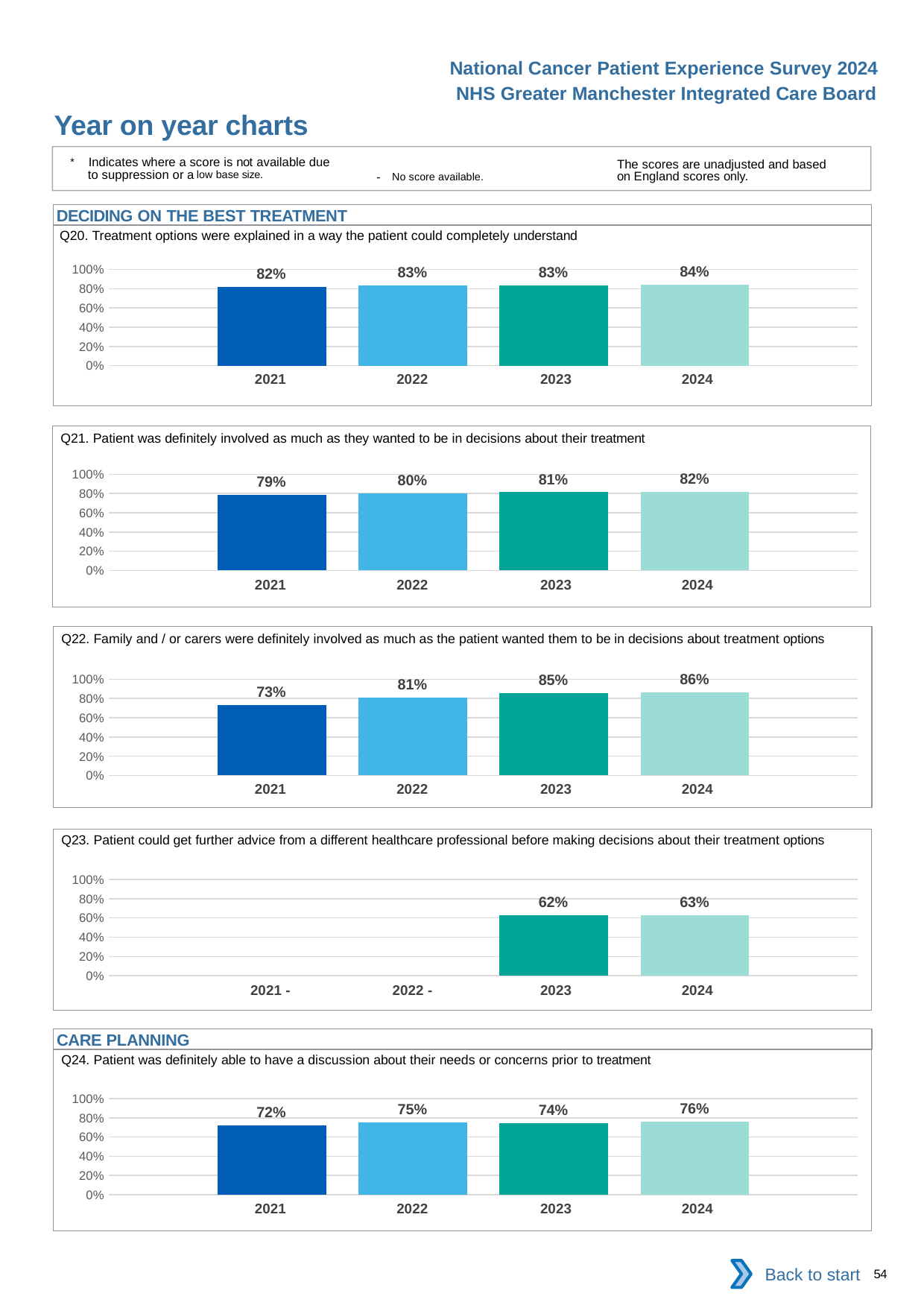
In the Q23 chart, what is the value for 2023? 62% What kind of chart is used for Q21? bar chart In the Q22 chart, which year has the lowest value? 2021 In the Q23 chart, how many years have a bar plotted? 2 In the Q24 chart, which is larger, the value for 2022 or the value for 2023? 2022 In the Q20 chart, is the value for 2021 greater or less than 80%? greater In the Q20 chart, what is the value for 2024? 84% In the Q22 chart, do the values rise or fall from 2021 to 2024? rise In the Q21 chart, what is the value for 2021? 79% In the Q22 chart, what is the difference between the 2024 and 2021 values? 13 percentage points In the Q24 chart, what is the difference between the 2024 and 2021 values? 4 percentage points In the Q24 chart, which year has the highest value? 2024